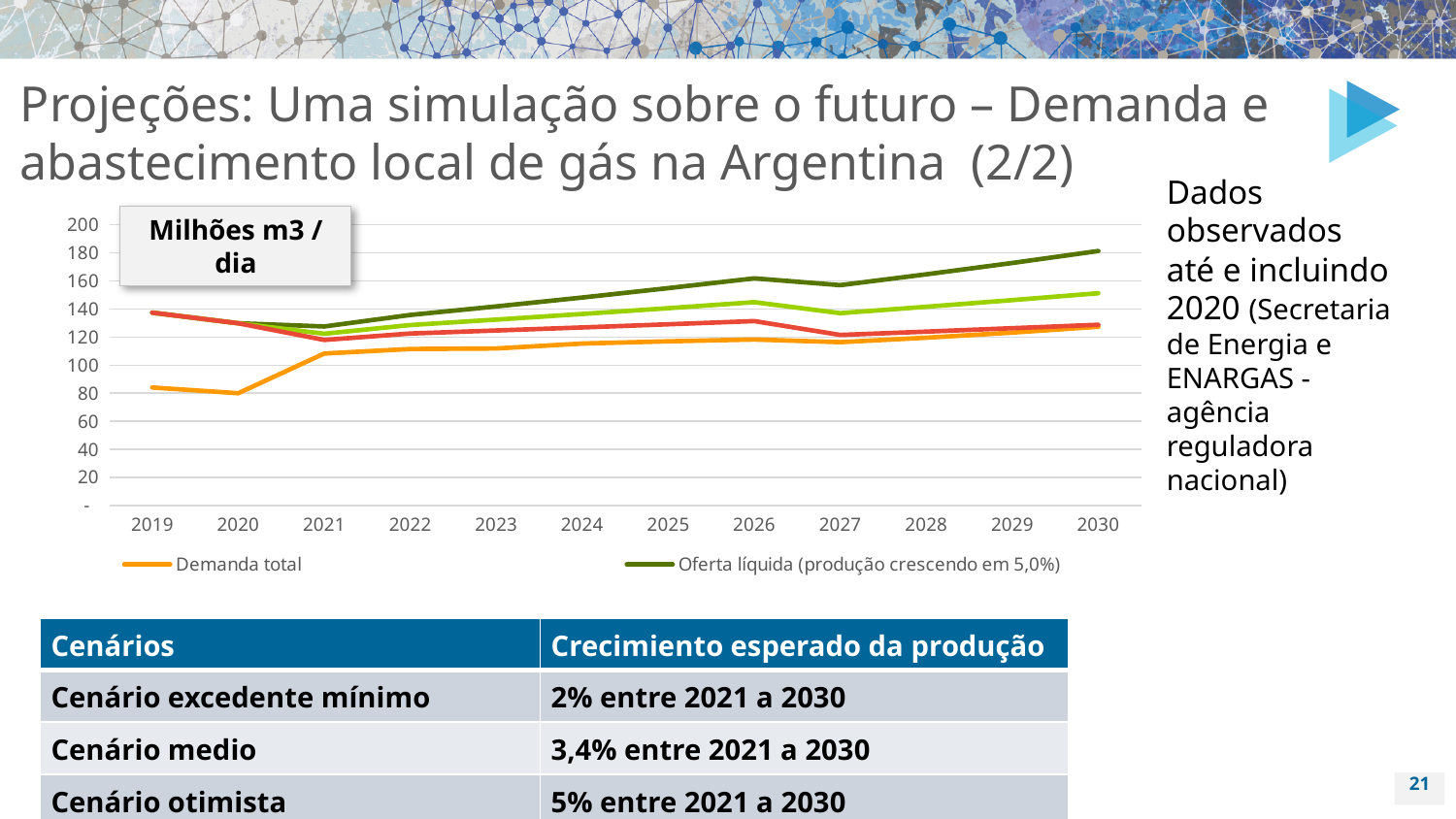
Does Oferta líquida (produção crescendo em 5,0%) generally rise or fall from 2021 to 2030? rise How many years are plotted along the x axis of the chart? 12 What unit is given in the label box at the top left of the chart? Milhões m3 / dia What is the legend entry for the dark green line? Oferta líquida (produção crescendo em 5,0%) Is the value for Oferta líquida (produção crescendo em 5,0%) in 2026 greater or less than 140? greater In which year is Demanda total at its lowest? 2020 Is the value for Demanda total in 2019 greater or less than 100? less Is the value for Oferta líquida (produção crescendo em 5,0%) in 2030 greater or less than 160? greater How many series does the chart legend list? 2 In 2030, which is higher: Demanda total or Oferta líquida (produção crescendo em 5,0%)? Oferta líquida (produção crescendo em 5,0%) What kind of chart is shown on the slide? line chart